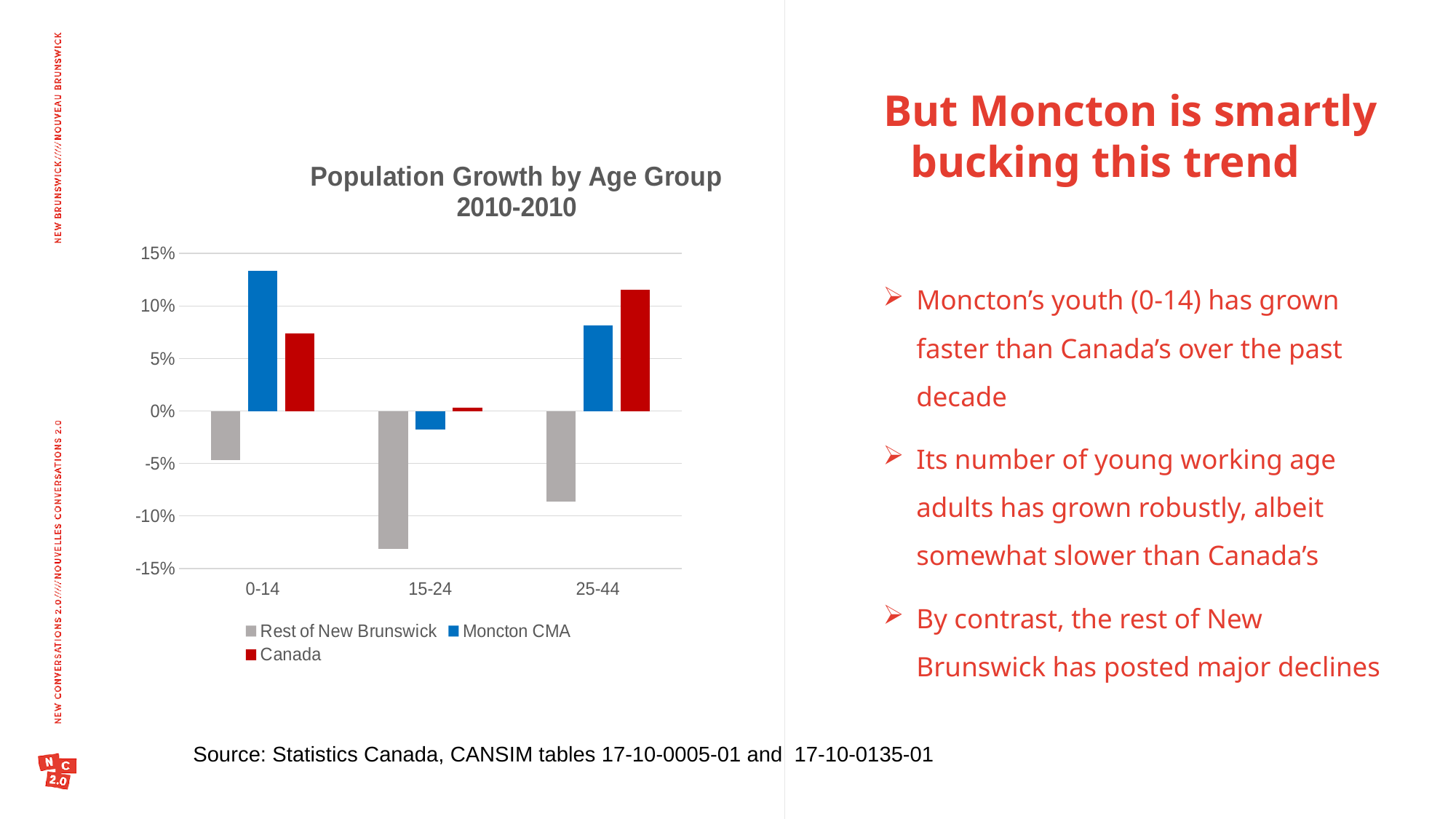
Is the Moncton CMA value for 0-14 greater or less than 10%? greater What is the title of the chart? Population Growth by Age Group 2010-2010 What colour represents Canada in the chart? Red Is the Rest of New Brunswick value for 15-24 greater or less than -10%? less In the 25-44 age group, which is larger: Moncton CMA or Canada? Canada For which age group is the Moncton CMA value highest? 0-14 How many series does the legend list? 3 What kind of chart is shown on the slide? Bar chart For which age group is the Rest of New Brunswick value lowest? 15-24 In the 0-14 age group, which is larger: Moncton CMA or Canada? Moncton CMA How many age groups are shown on the x axis? 3 For which age group is the Canada value highest? 25-44